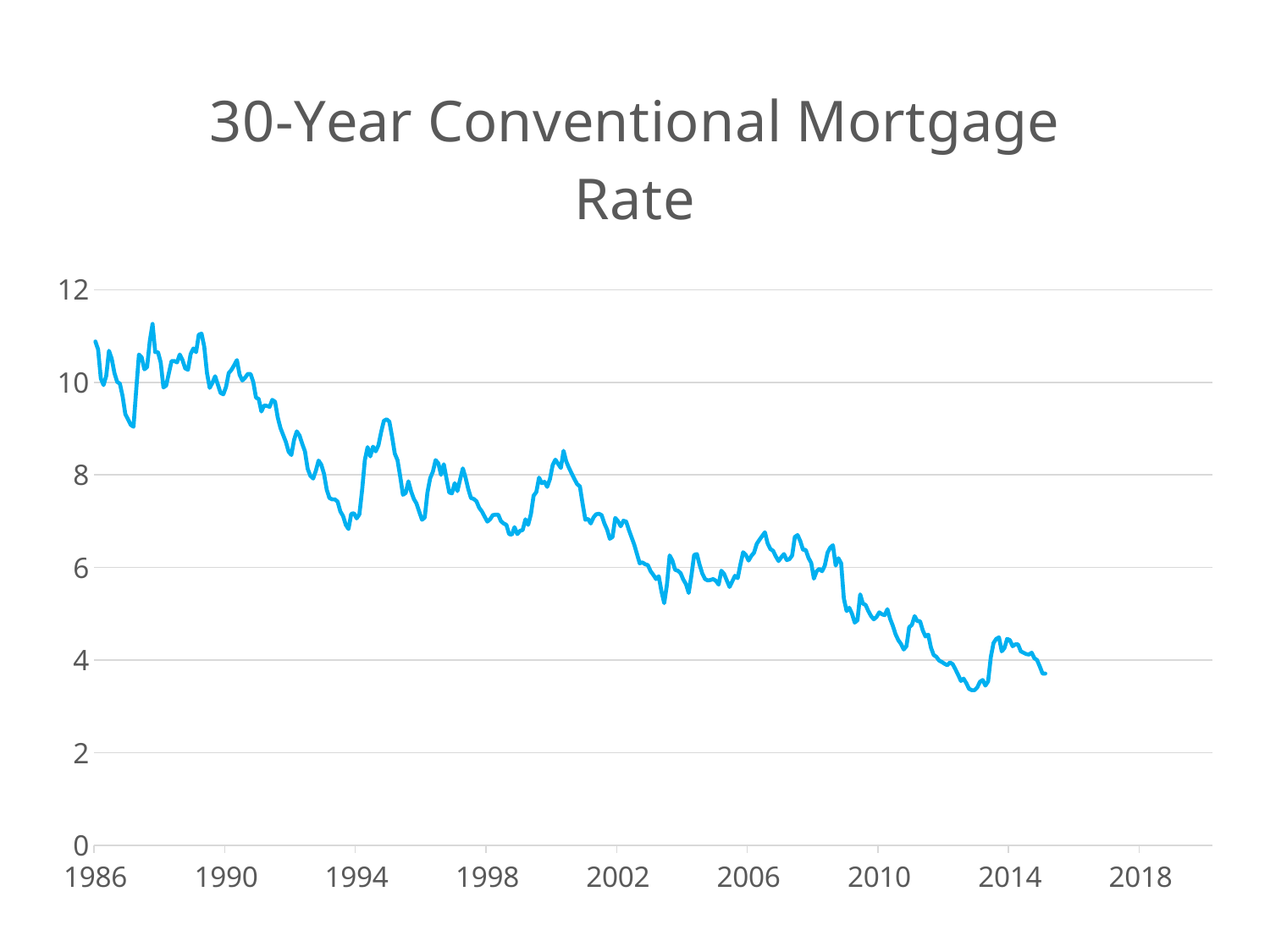
What kind of chart is shown on the slide? line chart How many lines are plotted on the chart? 1 Is the value in 1990 greater or less than 8? greater What is the highest value shown on the y axis? 12 What is the title of the chart? 30-Year Conventional Mortgage Rate Is the value in 1998 greater or less than 8? less Overall, do the values rise or fall from 1986 to 2014 along the x axis? fall Is the value in 2010 greater or less than 6? less